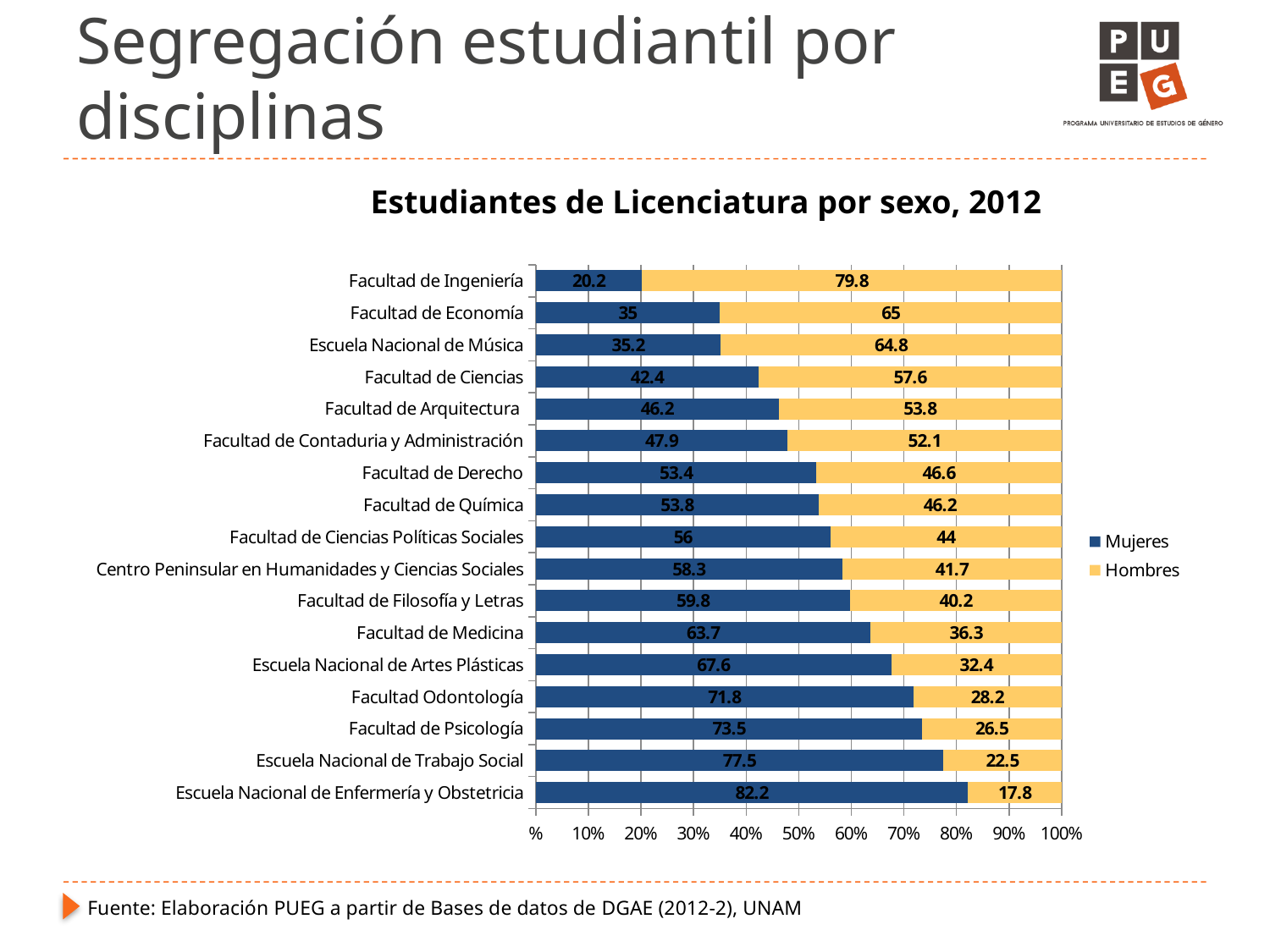
Which category has the highest Hombres value? Facultad de Ingeniería How many categories are shown on the chart? 17 What is the difference between the Hombres and Mujeres values for Facultad de Economía? 30 What is the Hombres value for Facultad de Medicina? 36.3 What is the Mujeres value for Facultad de Ingeniería? 20.2 What is the Mujeres value for Escuela Nacional de Trabajo Social? 77.5 Which category has the lowest Mujeres value? Facultad de Ingeniería Which is larger for Facultad de Derecho, the Mujeres value or the Hombres value? Mujeres Which category has the highest Mujeres value? Escuela Nacional de Enfermería y Obstetricia How many series does the legend list? 2 What is the title of the chart? Estudiantes de Licenciatura por sexo, 2012 What kind of chart is shown on the slide? Stacked bar chart